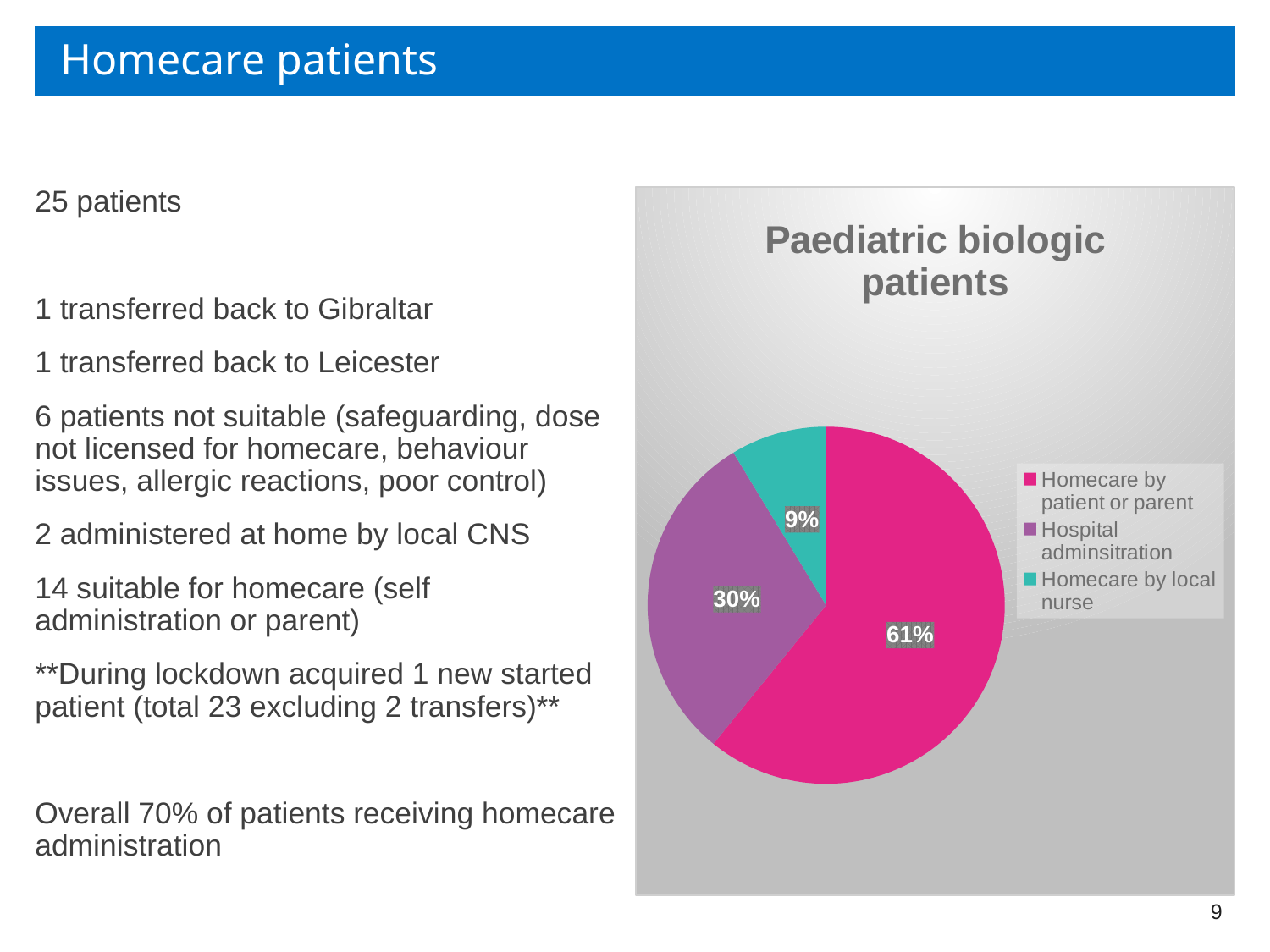
How many slices does the pie chart have? 3 Which category has the smallest share of the pie? Homecare by local nurse What is the title of the pie chart? Paediatric biologic patients Which is larger: the share for 'Hospital adminsitration' or the share for 'Homecare by local nurse'? Hospital adminsitration What percentage of the pie is 'Homecare by patient or parent'? 61% How many entries does the legend list? 3 What percentage of the pie is 'Homecare by local nurse'? 9% What colour is the 'Homecare by local nurse' slice? teal What type of chart is shown on the slide? pie chart What percentage of the pie is 'Hospital adminsitration'? 30% What is the difference in percentage points between 'Homecare by patient or parent' and 'Hospital adminsitration'? 31 Which category has the largest share of the pie? Homecare by patient or parent